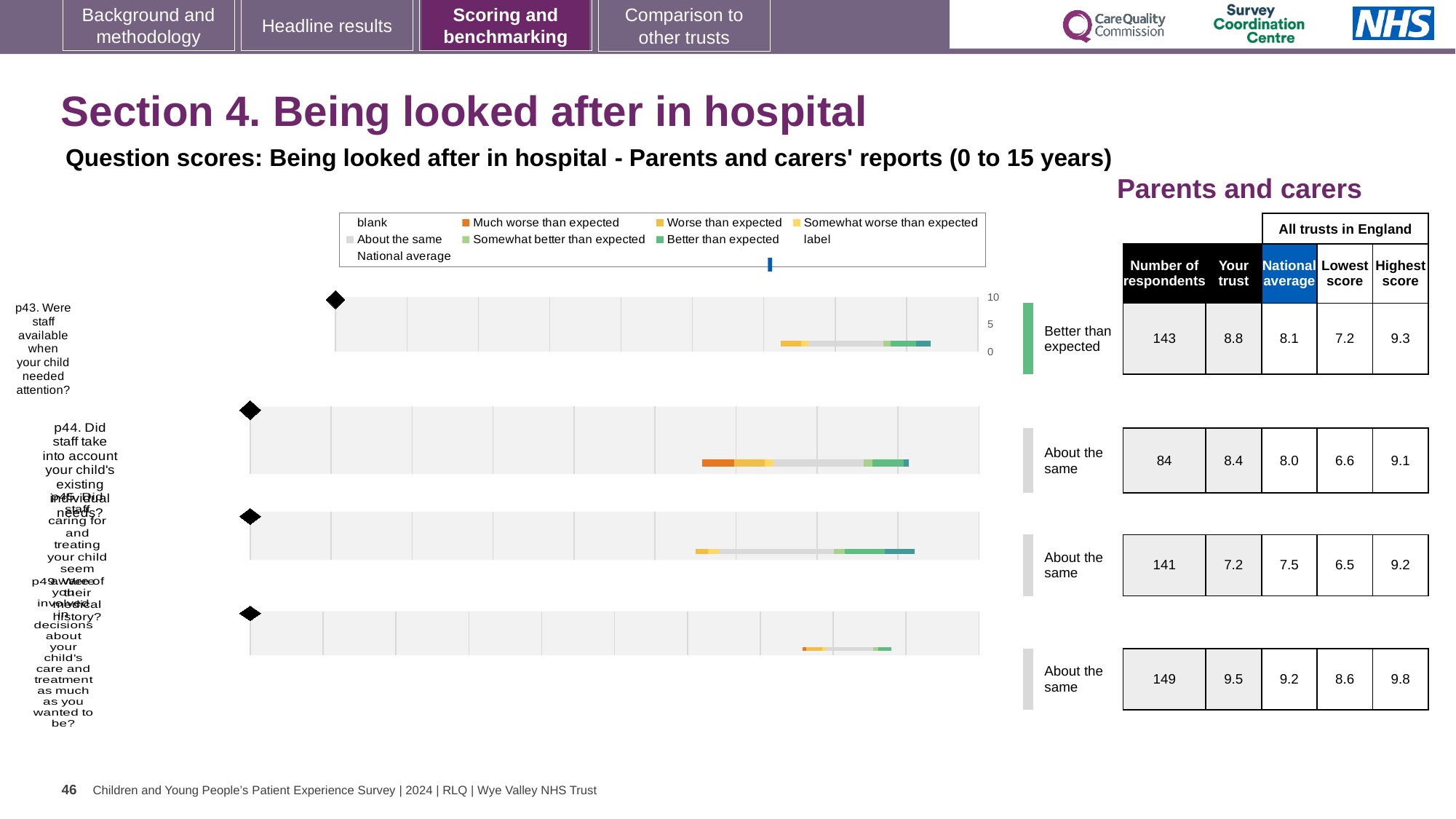
For question p43 (Were staff available when your child needed attention?), what is the 'Your trust' score shown in the table? 8.8 Which chart row has the highest 'Your trust' score? The bottom (fourth) row, 9.5 For question p43, which is larger: the 'Your trust' score or the national average? Your trust (8.8) How many of the four question rows are rated 'About the same'? 3 What kind of chart is used for each question row? Bar chart (horizontal stacked bar) For question p43, what is the difference between the 'Your trust' score and the national average? 0.7 How many respondents are listed for question p43 (the top chart row)? 143 For question p43, what is the national average score shown in the table? 8.1 What benchmark category is shown for question p43? Better than expected Which chart row has the lowest 'Your trust' score? The third row, 7.2 For the bottom chart row, what is the highest score among all trusts in England? 9.8 How many question rows (charts) are shown on the slide? 4